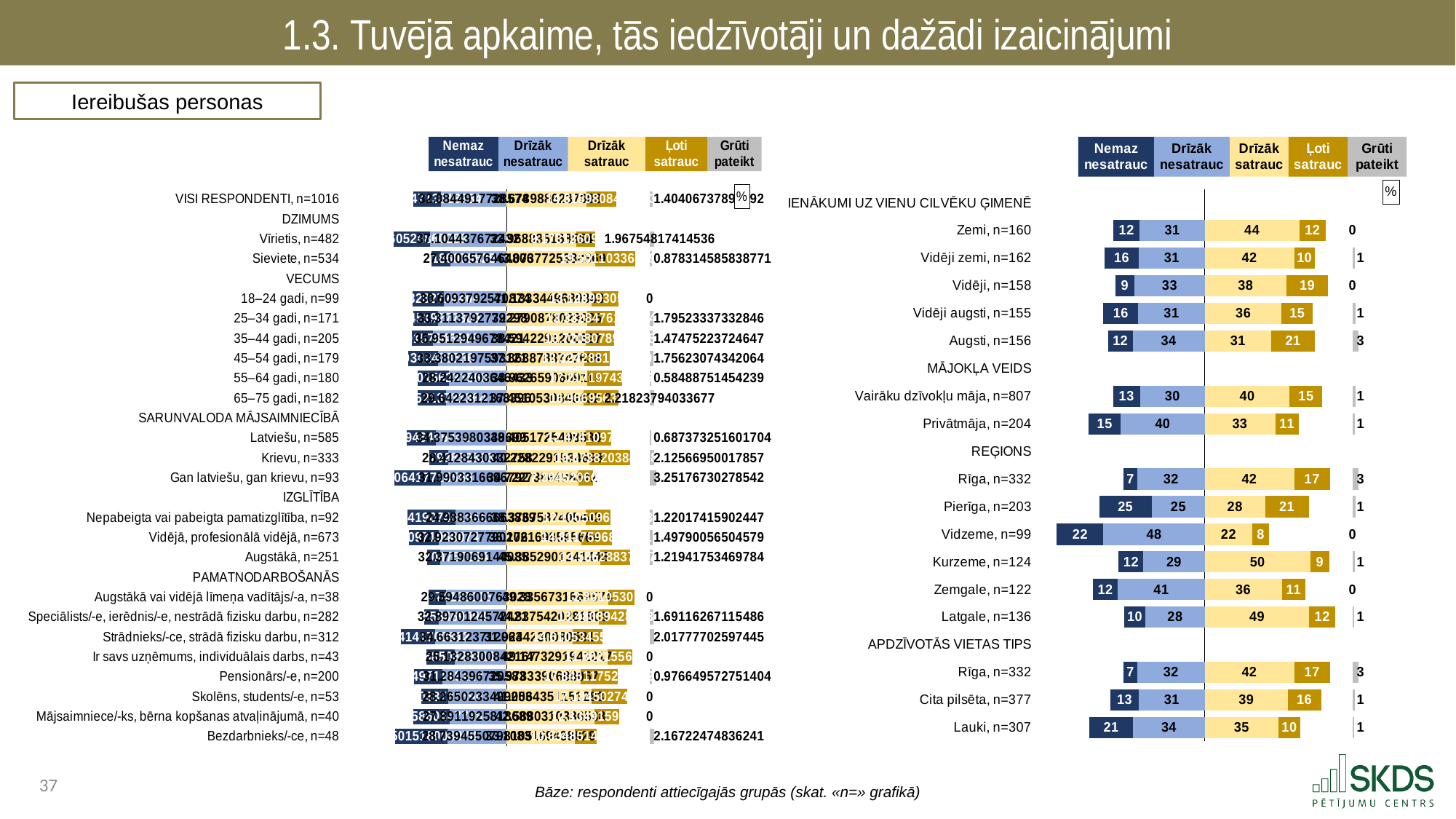
How many series does the legend of the right-hand chart list? 5 In the right-hand chart, what is the value for "Grūti pateikt" for Rīga, n=332 under REĢIONS? 3 In the right-hand chart, what is the total of the stacked bar for Zemi, n=160? 99 In the right-hand chart, which has the larger "Drīzāk nesatrauc" value: Privātmāja, n=204 or Vairāku dzīvokļu māja, n=807? Privātmāja, n=204 In the right-hand chart, what is the difference between the "Drīzāk satrauc" values for Zemi, n=160 and Augsti, n=156? 13 What kind of chart is the right-hand chart? Stacked bar chart In the right-hand chart, what is the value for "Drīzāk nesatrauc" for Vidzeme, n=99? 48 In the right-hand chart, which region under REĢIONS has the highest "Drīzāk satrauc" value? Kurzeme, n=124 In the right-hand chart, what is the value for "Ļoti satrauc" for Augsti, n=156? 21 In the right-hand chart, which region under REĢIONS has the lowest "Nemaz nesatrauc" value? Rīga, n=332 In the right-hand chart, what is the value for "Drīzāk satrauc" for Kurzeme, n=124? 50 In the right-hand chart, what is the value for "Nemaz nesatrauc" for Pierīga, n=203? 25